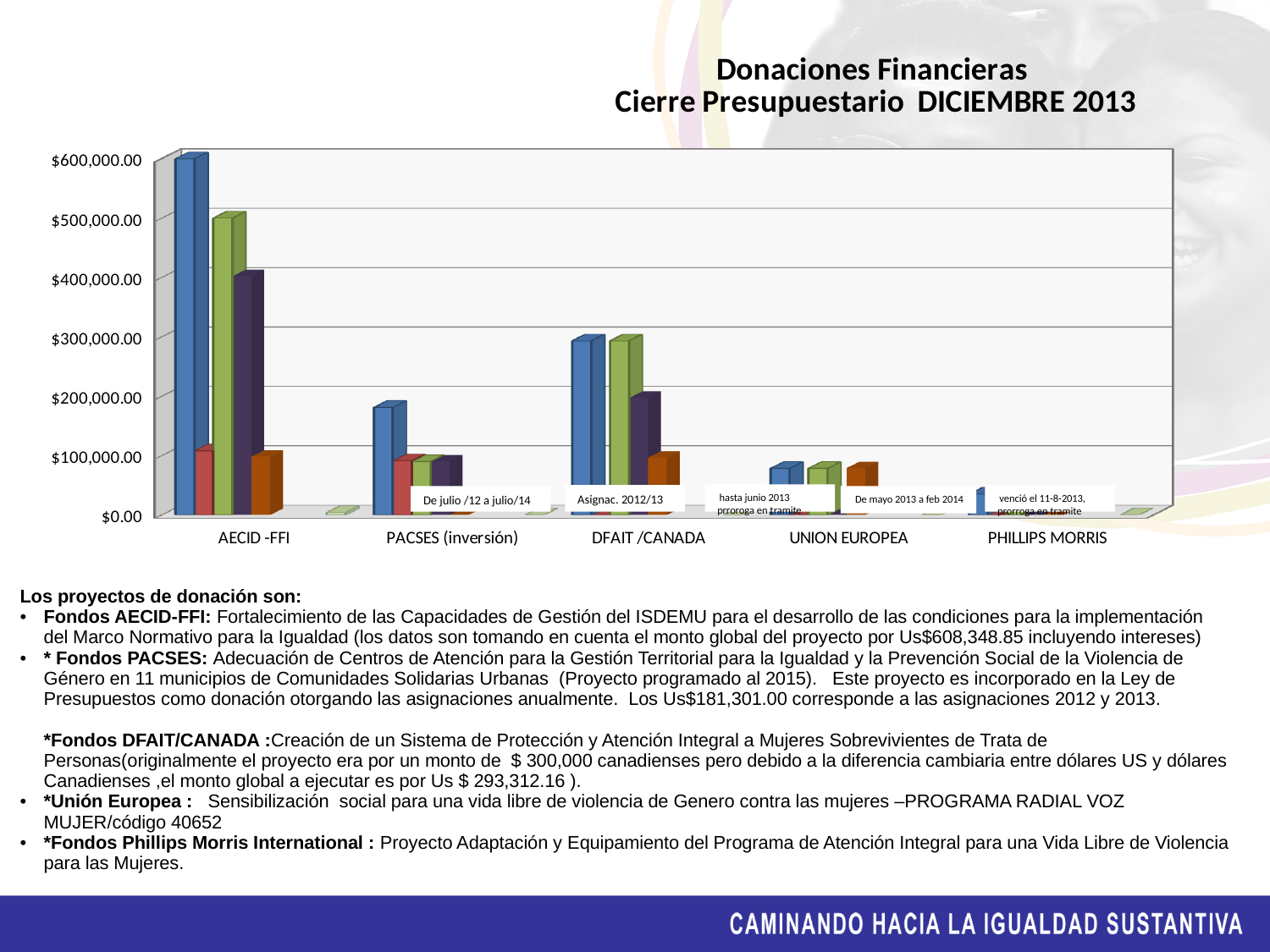
What is the title shown above the chart? Donaciones Financieras Cierre Presupuestario DICIEMBRE 2013 Which category has the smallest bars in the chart? PHILLIPS MORRIS How many categories are shown along the x axis of the chart? 5 What is the highest value shown on the vertical axis of the chart? $600,000.00 Which category has the tallest bar in the chart? AECID -FFI Is the value of the first (blue) bar for AECID -FFI greater or less than $500,000.00? greater Which has a larger first (blue) bar, AECID -FFI or PACSES (inversión)? AECID -FFI What kind of chart is shown on the slide? bar chart Is the value of the first (blue) bar for DFAIT /CANADA greater or less than $200,000.00? greater Is the value of the first (blue) bar for UNION EUROPEA greater or less than $100,000.00? less Which has a larger first (blue) bar, DFAIT /CANADA or UNION EUROPEA? DFAIT /CANADA